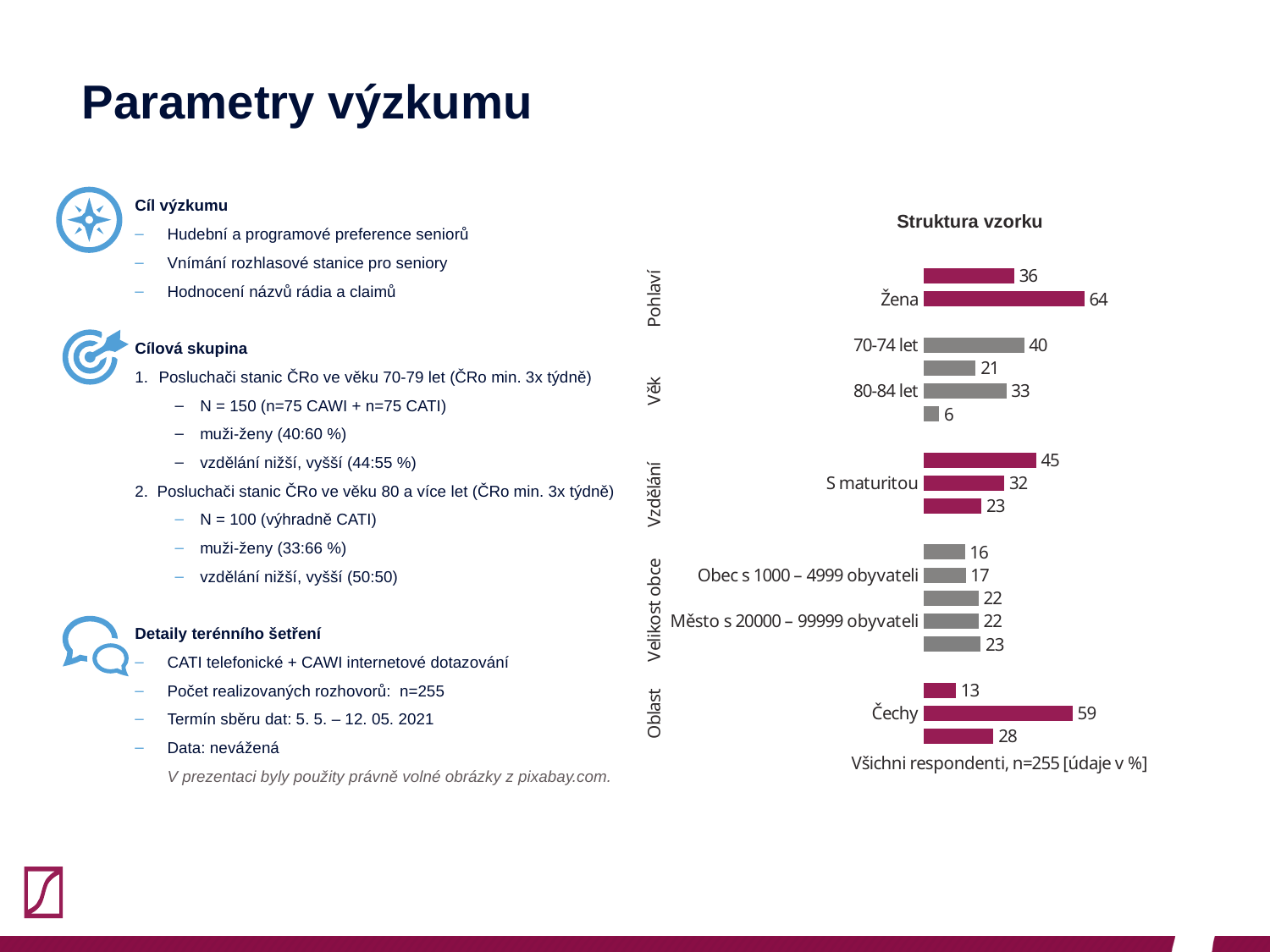
In the chart 'Struktura vzorku', what is the value for Čechy? 59 In the chart 'Struktura vzorku', what is the difference between the values for 70-74 let and 80-84 let? 7 In the chart 'Struktura vzorku', which has the larger value, Žena or Čechy? Žena In the chart 'Struktura vzorku', what is the value for 80-84 let? 33 In the chart 'Struktura vzorku', what is the value for Žena? 64 In the chart 'Struktura vzorku', which labelled category has the highest value? Žena In the chart 'Struktura vzorku', what is the value for Město s 20000 – 99999 obyvateli? 22 What kind of chart is 'Struktura vzorku'? Bar chart In the chart 'Struktura vzorku', what is the value for S maturitou? 32 In the chart 'Struktura vzorku', what is the value for 70-74 let? 40 How many group labels (Pohlaví, Věk, etc.) are shown along the vertical axis of the chart 'Struktura vzorku'? 5 In the chart 'Struktura vzorku', what is the value for Obec s 1000 – 4999 obyvateli? 17